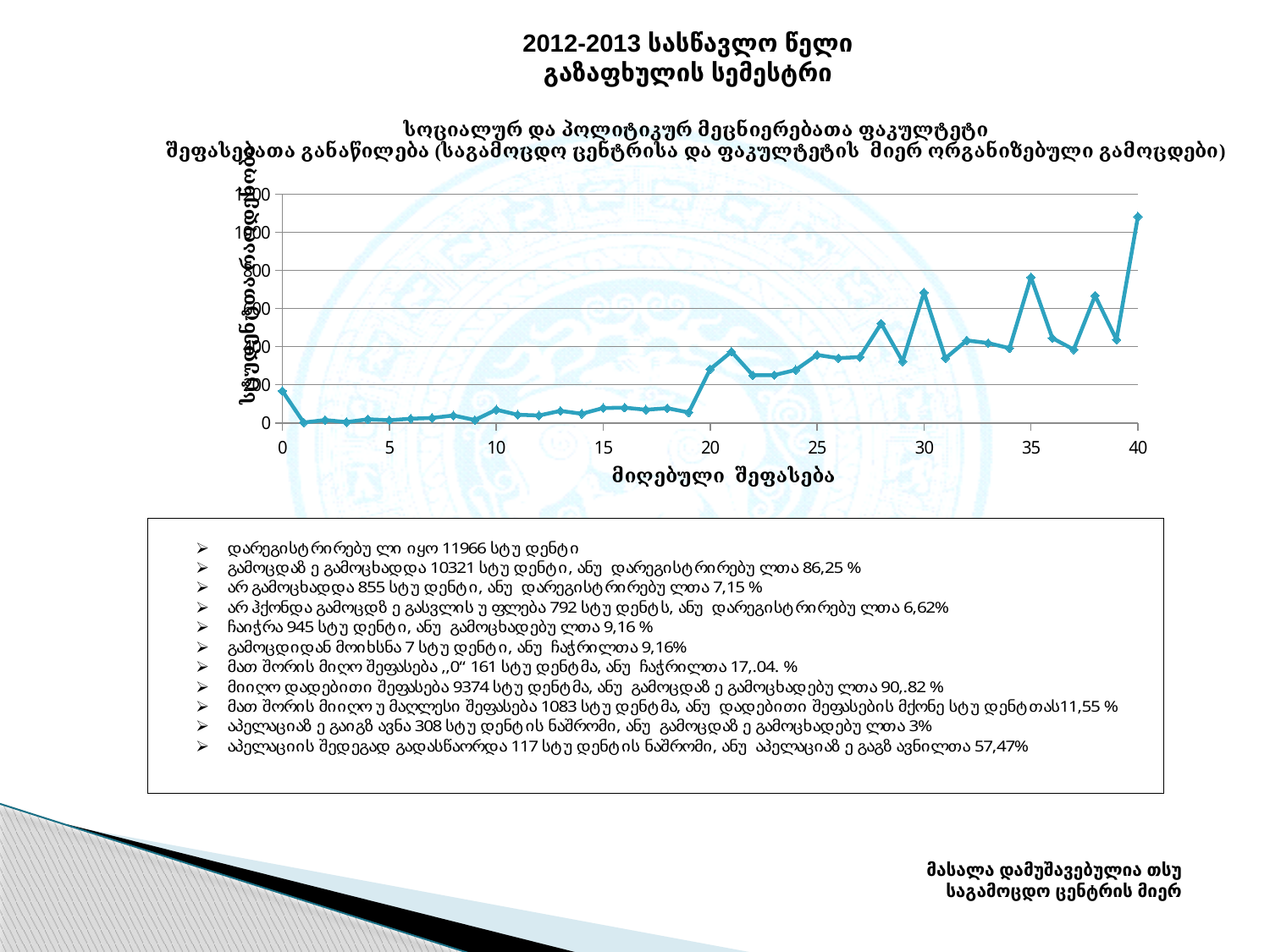
Is the value at score 0 greater or less than 200? less Is the value at score 20 greater or less than 400? less Overall, do the values rise or fall as the score increases along the x axis? rise What is the title of the x axis? მიღებული შეფასება Which is larger, the value at score 40 or the value at score 35? score 40 What kind of chart is shown on the slide? line chart Is the value at score 30 greater or less than 800? less Which is larger, the value at score 30 or the value at score 20? score 30 Which is larger, the value at score 0 or the value at score 5? score 0 At which x-axis value (score) does the line reach its highest point? 40